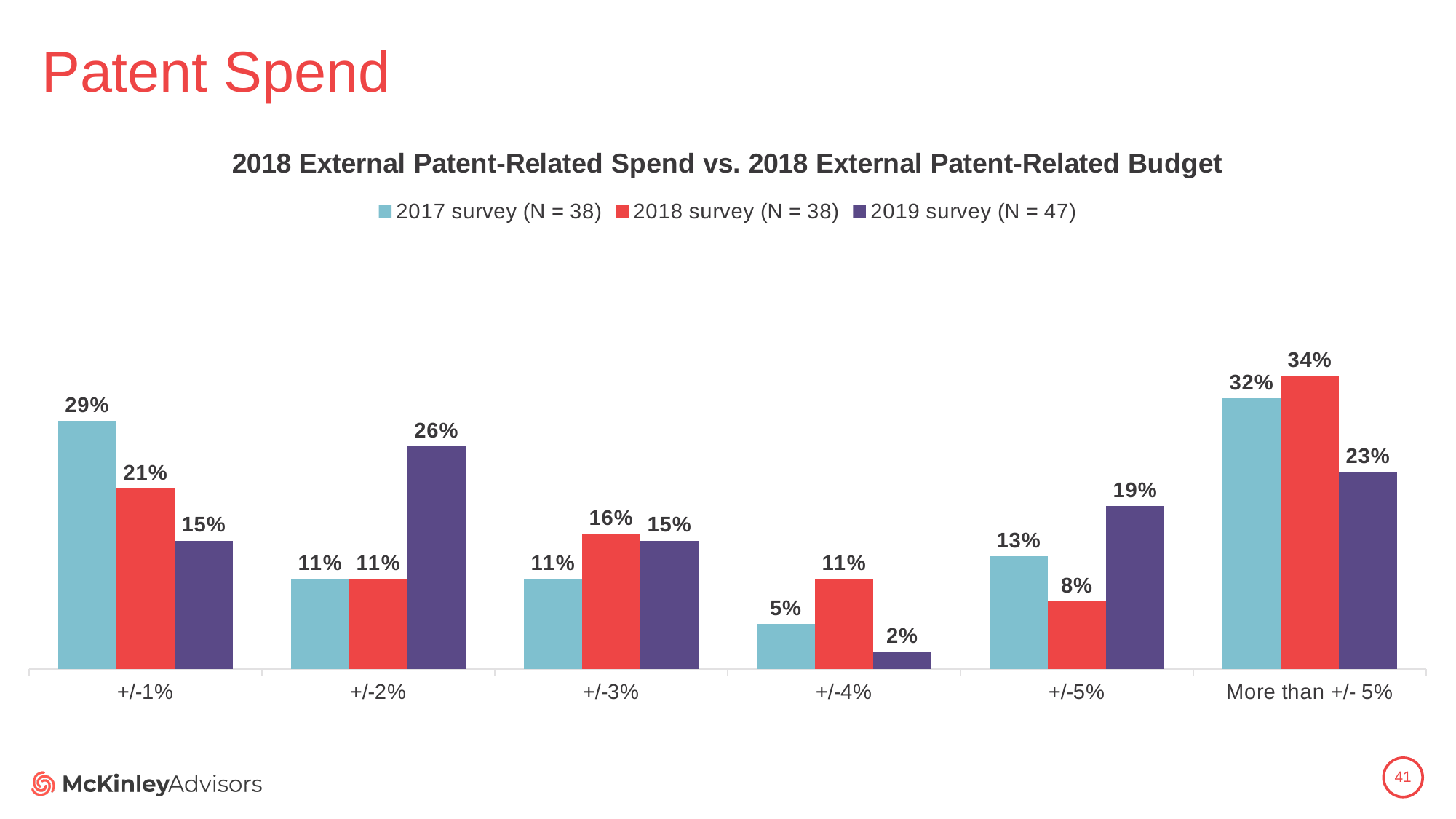
What is the title of the chart? 2018 External Patent-Related Spend vs. 2018 External Patent-Related Budget How many series does the legend list? 3 Which category has the highest value for the 2018 survey? More than +/- 5% Which is larger in the +/-3% category: the 2017 survey value or the 2018 survey value? 2018 survey What is the value for the 2018 survey in the +/-5% category? 8% Which category has the lowest value for the 2019 survey? +/-4% What kind of chart is shown on the slide? Bar chart What is the value for the 2017 survey in the +/-1% category? 29% What is the sample size (N) for the 2019 survey according to the legend? 47 What is the difference between the 2018 survey and 2019 survey values in the More than +/- 5% category? 11% What is the value for the 2019 survey in the +/-2% category? 26% How many categories are shown on the x axis? 6